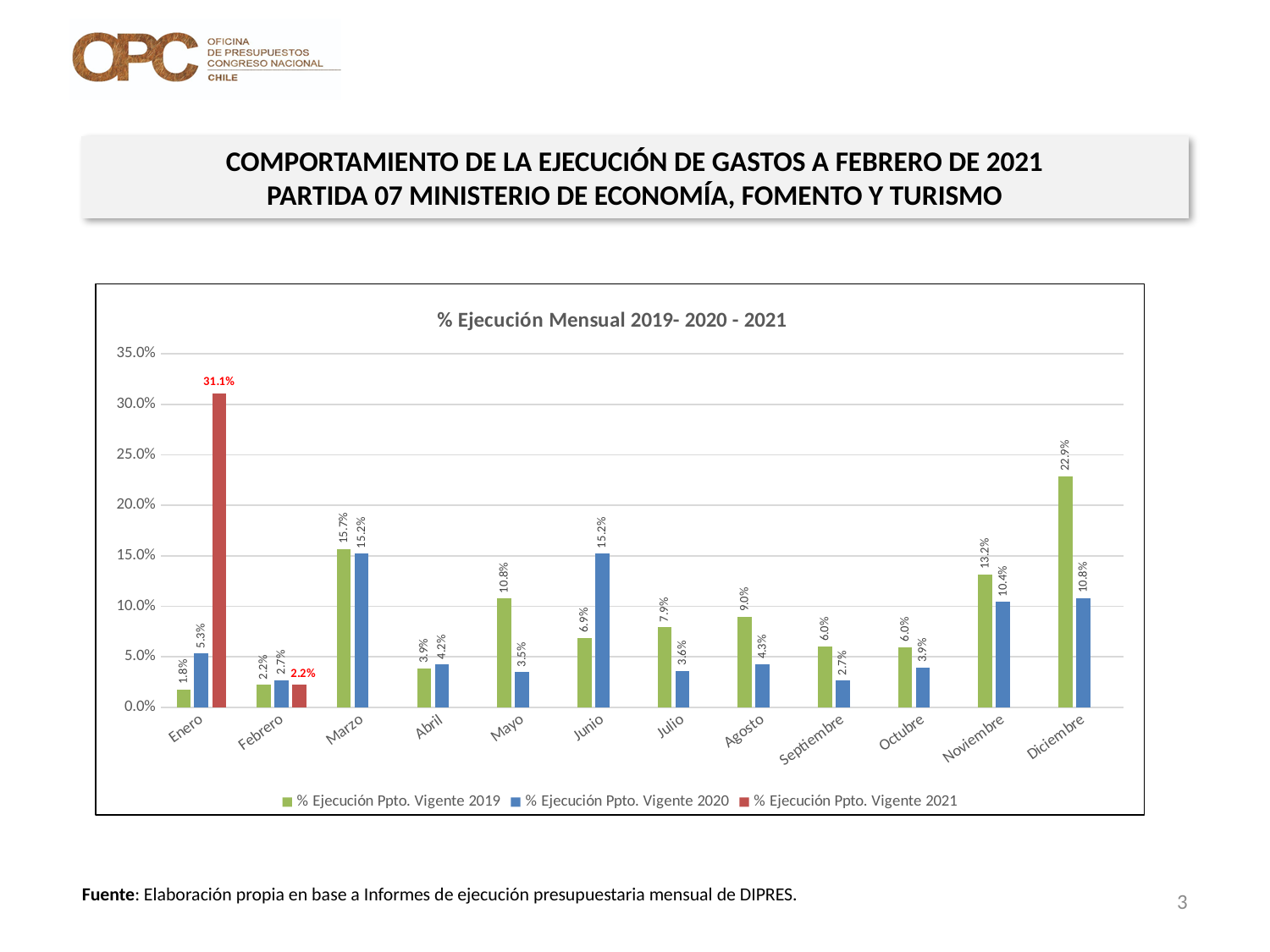
How many months are shown on the x axis? 12 What is the title of the chart? % Ejecución Mensual 2019- 2020 - 2021 Which month has the highest value in the % Ejecución Ppto. Vigente 2019 series? Diciembre What is the difference between the 2021 and 2020 values for Enero? 25.8% How many series does the legend list? 3 Which month has the lowest value in the % Ejecución Ppto. Vigente 2019 series? Enero What kind of chart is shown? Bar chart What is the value for Enero in the % Ejecución Ppto. Vigente 2021 series? 31.1% What is the value for Diciembre in the % Ejecución Ppto. Vigente 2019 series? 22.9% What is the difference between the 2019 and 2020 values for Mayo? 7.3% Which is larger for Junio: the 2019 value or the 2020 value? 2020 What is the value for Junio in the % Ejecución Ppto. Vigente 2020 series? 15.2%